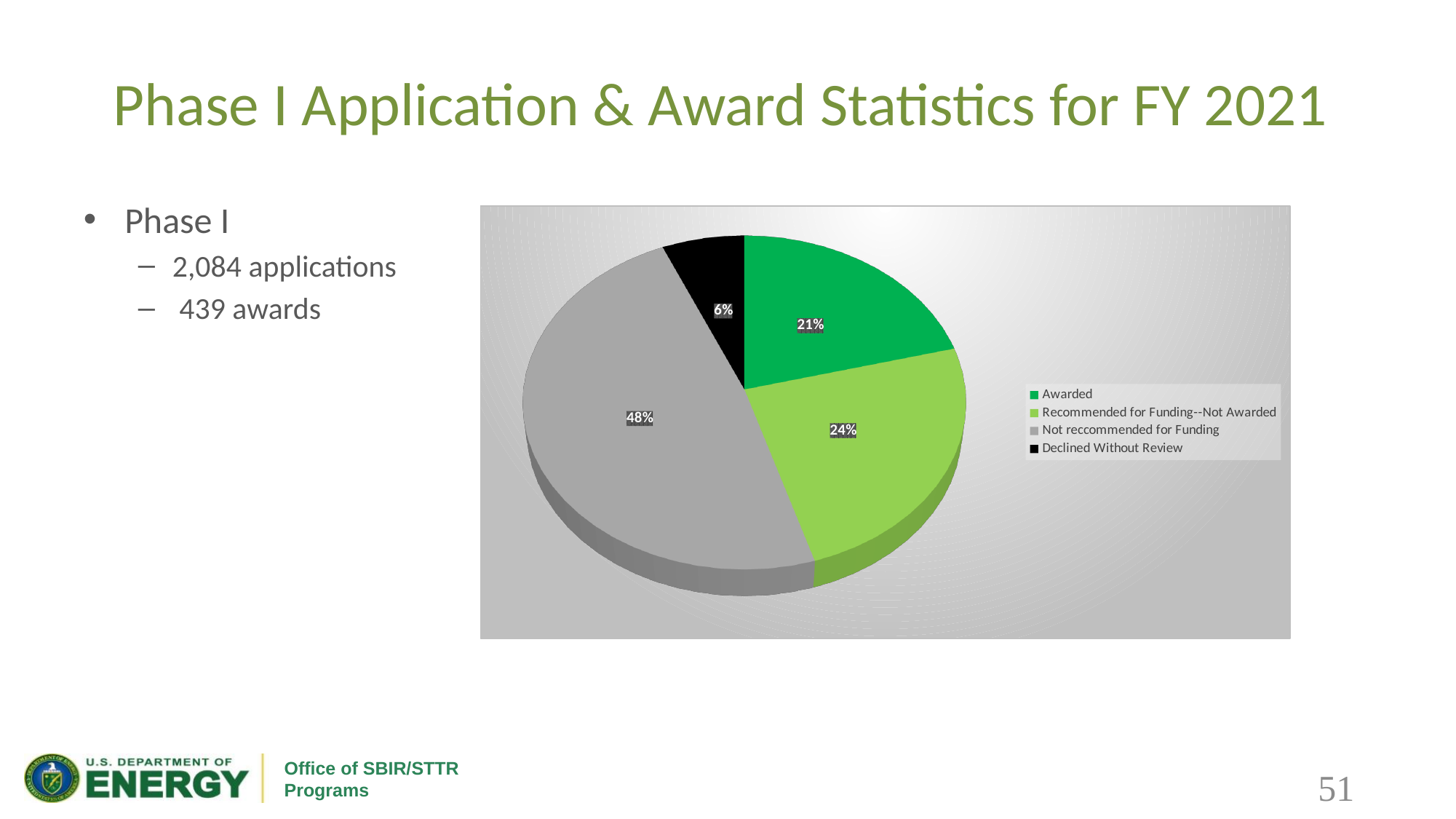
What is the difference in percentage points between the Not recommended for Funding slice and the Awarded slice? 27 Which category has the smallest slice of the pie? Declined Without Review What kind of chart is shown on the slide? pie chart What percentage of the pie is labelled Not recommended for Funding? 48% Which category has the largest slice of the pie? Not recommended for Funding How many entries does the legend list? 4 How many slices does the pie chart have? 4 What colour is the Declined Without Review slice? black What percentage of the pie is labelled Awarded? 21% What percentage of the pie is labelled Recommended for Funding--Not Awarded? 24% What percentage of the pie is labelled Declined Without Review? 6% Which slice is larger: Awarded or Recommended for Funding--Not Awarded? Recommended for Funding--Not Awarded